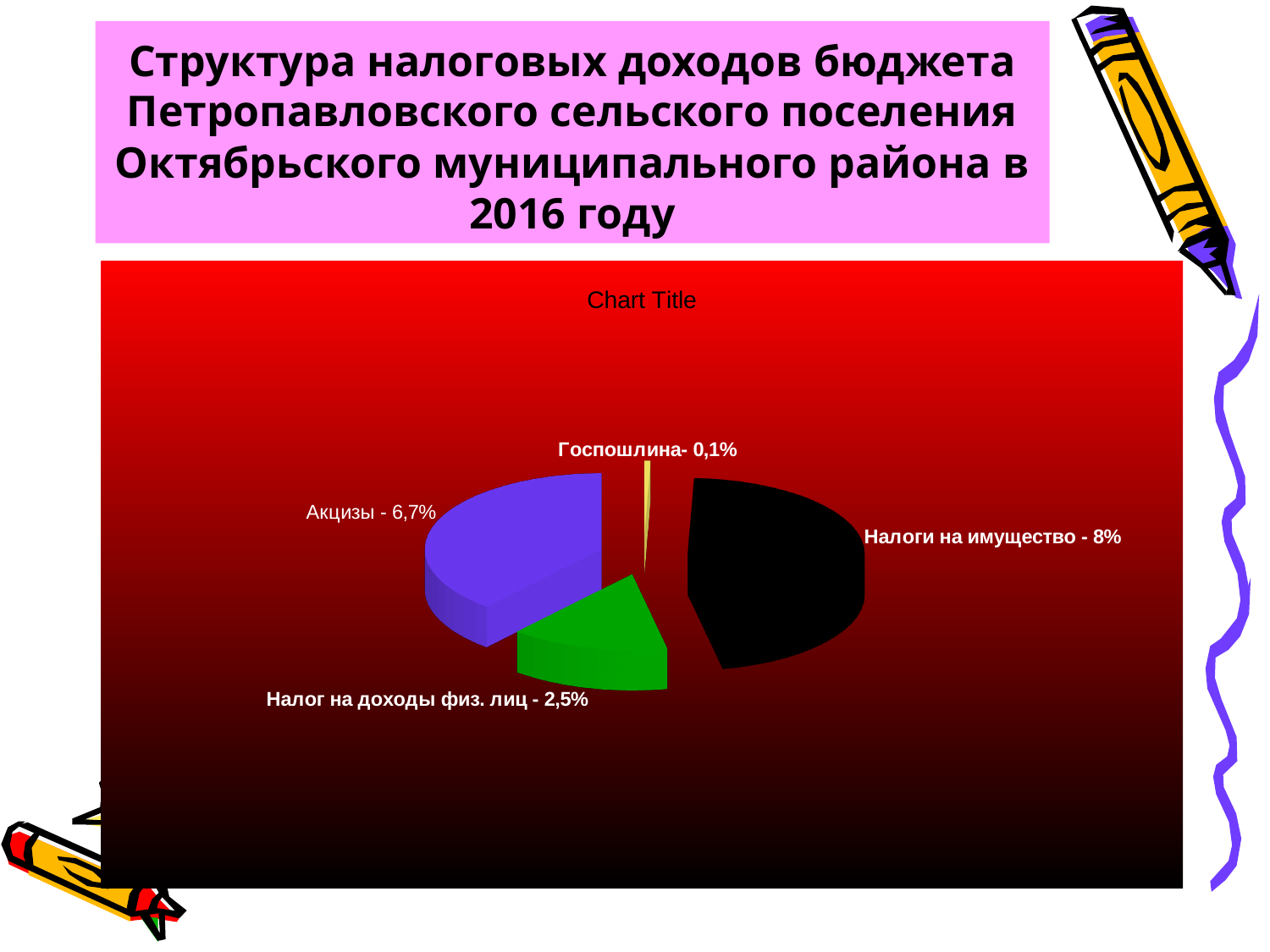
What value is shown for Акцизы? 6,7% Which category has the lowest value? Госпошлина What is the difference between the values for Налоги на имущество and Акцизы? 1,3% What is the difference between the values for Акцизы and Налог на доходы физ. лиц? 4,2% What colour is the slice for Налог на доходы физ. лиц? Green Which category has the highest value? Налоги на имущество What kind of chart is shown on the slide? Pie chart What value is shown for Налоги на имущество? 8% How many slices does the pie chart have? 4 What value is shown for Налог на доходы физ. лиц? 2,5% What value is shown for Госпошлина? 0,1% Which is larger, the value for Акцизы or the value for Налог на доходы физ. лиц? Акцизы